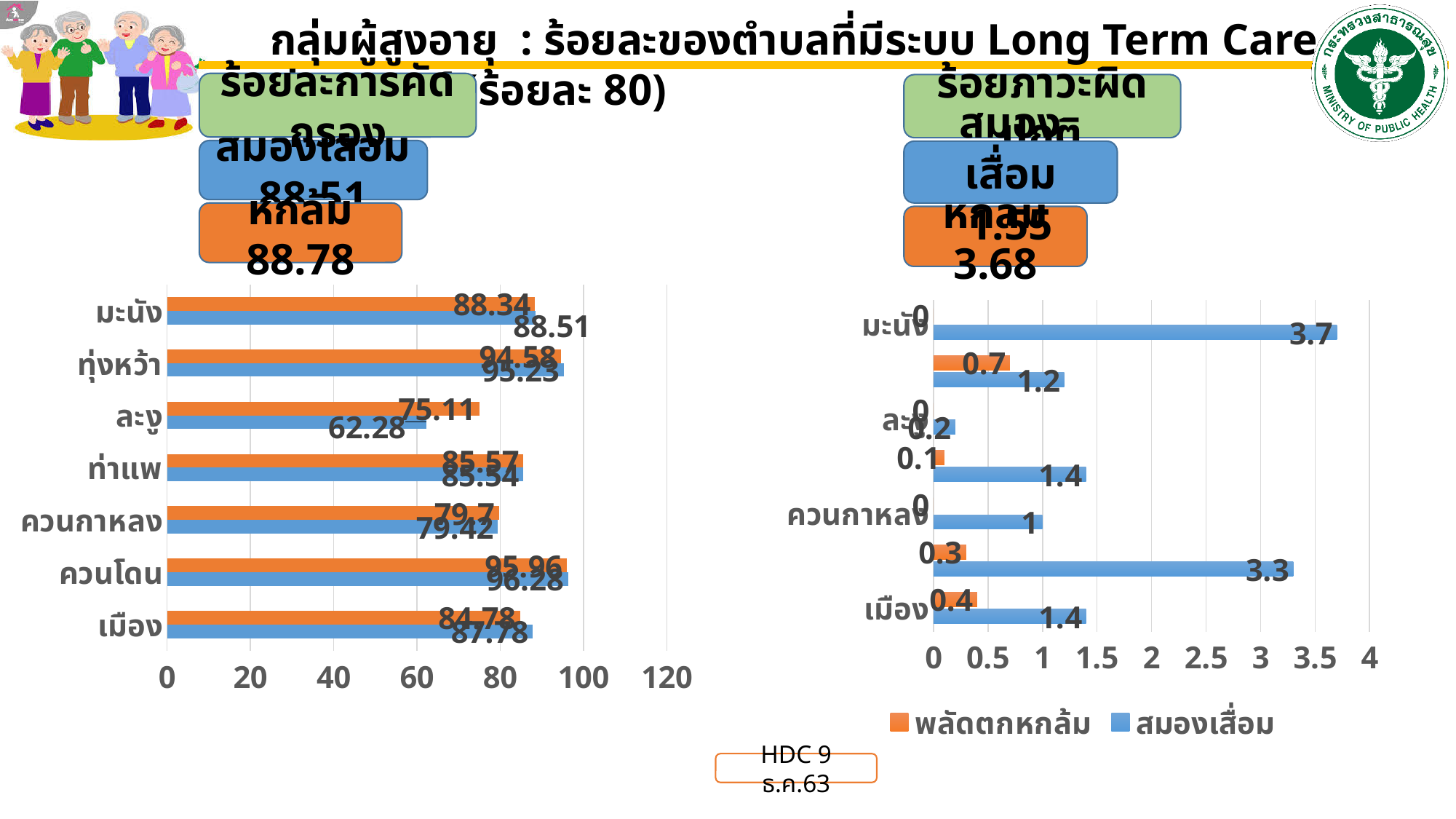
How many series does the legend of the right chart list? 2 How many categories are shown in the left chart? 7 In the left chart, which category has the highest blue bar? ควนโดน In the right chart, what is the พลัดตกหกล้ม value for เมือง? 0.4 In the right chart, which is larger: the สมองเสื่อม value for มะนัง or for เมือง? มะนัง In the left chart, what is the value of the blue bar for ละงู? 62.28 In the left chart, what is the difference between the orange bar and the blue bar for ละงู? 12.83 In the left chart, is the blue bar for ละงู greater or less than 80? less What kind of chart is the left chart on the slide? bar chart In the right chart, what is the สมองเสื่อม value for มะนัง? 3.7 In the left chart, what is the value of the orange bar for ควนโดน? 95.96 In the left chart, which category has the lowest blue bar? ละงู